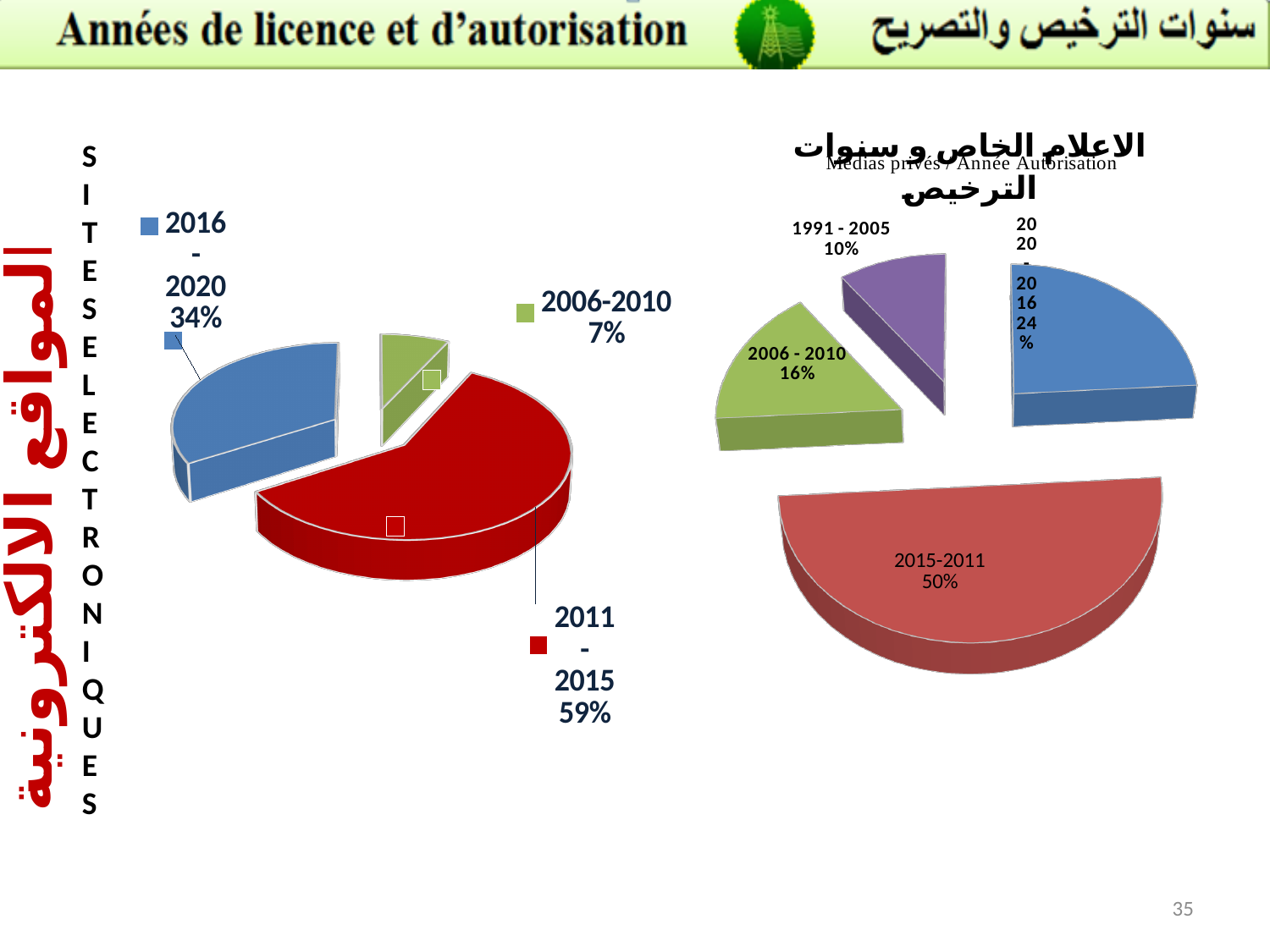
On the right pie chart (Médias privés / Année Autorisation), which period has the smallest share? 1991 - 2005 What type of chart is used on the left side of the slide? Pie chart On the right pie chart (Médias privés / Année Autorisation), how many slices are there? 4 On the left pie chart (Sites électroniques), what share is shown for 2016-2020? 34% On the left pie chart (Sites électroniques), what share is shown for 2011-2015? 59% On the left pie chart (Sites électroniques), how many slices are there? 3 On the right pie chart (Médias privés / Année Autorisation), what share is shown for 2006-2010? 16% On the right pie chart (Médias privés / Année Autorisation), what share is shown for 2015-2011? 50% On the left pie chart (Sites électroniques), what share is shown for 2006-2010? 7% On the left pie chart (Sites électroniques), which period has the largest share? 2011-2015 On the left pie chart (Sites électroniques), which period has the smallest share? 2006-2010 On the right pie chart (Médias privés / Année Autorisation), what share is shown for 1991-2005? 10%